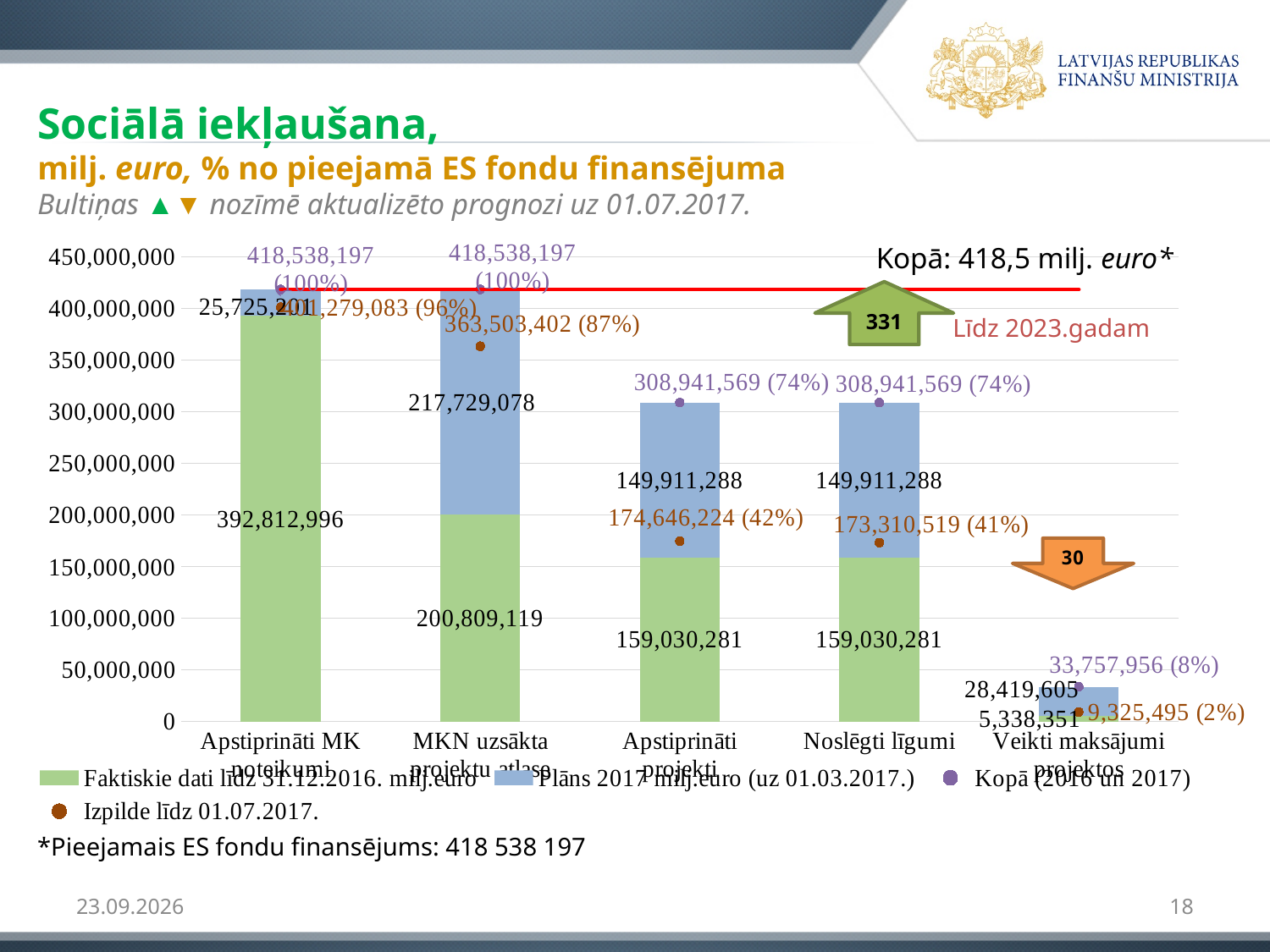
For MKN uzsākta projektu atlase, what is the difference between the Kopā (2016 un 2017) value and the Izpilde līdz 01.07.2017. value? 55,034,795 What is the total of the stacked bar for Apstiprināti projekti? 308,941,569 What is the Izpilde līdz 01.07.2017. value shown for Apstiprināti projekti? 174,646,224 (42%) What is the Kopā (2016 un 2017) value for Veikti maksājumi projektos? 33,757,956 (8%) How many categories are shown on the x axis? 5 How many series does the legend list? 4 Which category has the lowest Faktiskie dati līdz 31.12.2016. value? Veikti maksājumi projektos What is the value of Faktiskie dati līdz 31.12.2016. for Apstiprināti MK noteikumi? 392,812,996 For MKN uzsākta projektu atlase, which is larger: Faktiskie dati līdz 31.12.2016. or Plāns 2017? Plāns 2017 What kind of chart is shown on the slide? combination bar and line chart (stacked bars with point markers and a line) Which category has the highest Faktiskie dati līdz 31.12.2016. value? Apstiprināti MK noteikumi What is the Plāns 2017 value for MKN uzsākta projektu atlase? 217,729,078